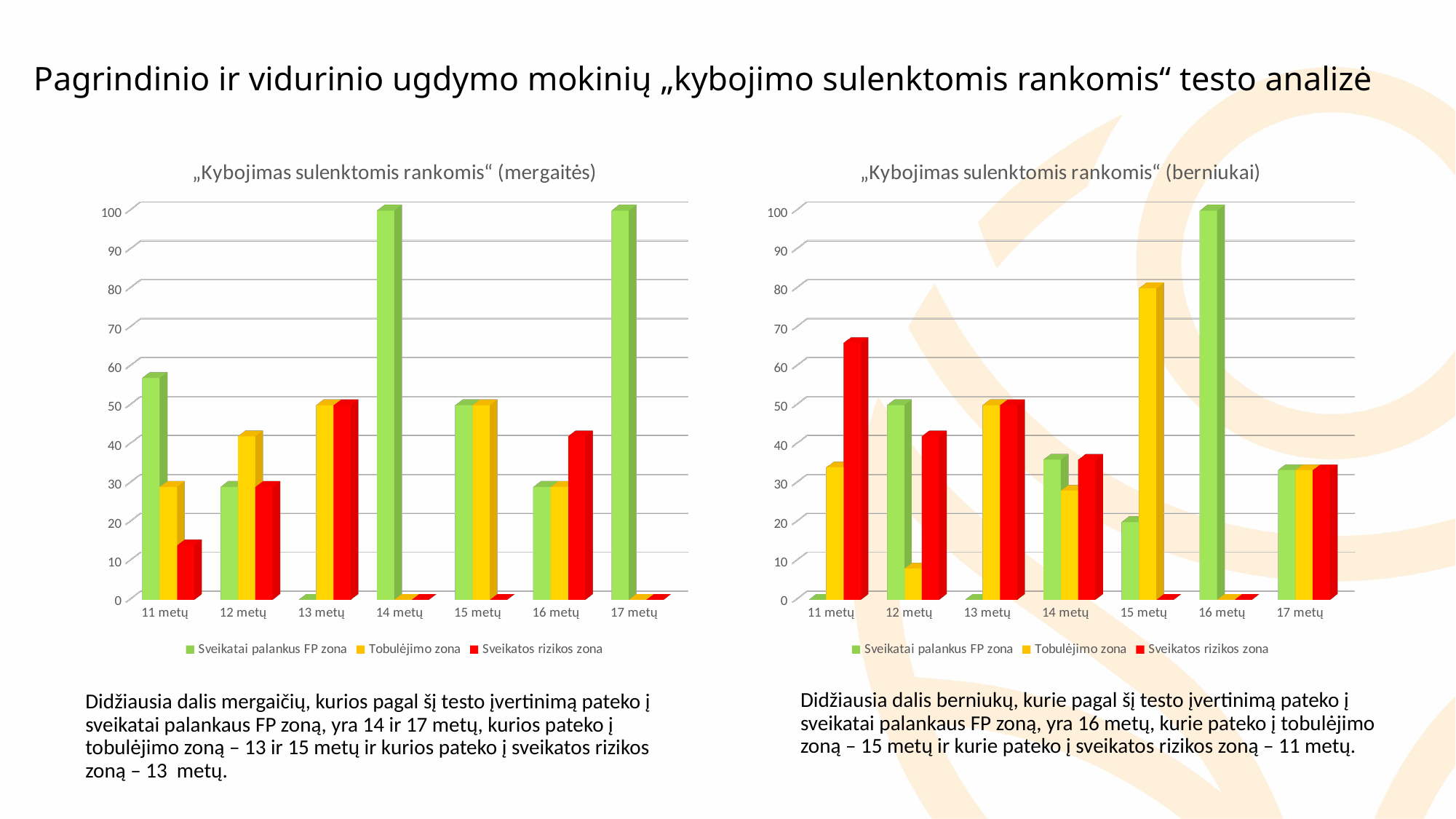
In the "Kybojimas sulenktomis rankomis" (berniukai) chart, which age group has the highest Sveikatos rizikos zona value? 11 metų In the "Kybojimas sulenktomis rankomis" (berniukai) chart, which is larger for 12 metų: Sveikatai palankus FP zona or Tobulėjimo zona? Sveikatai palankus FP zona Which colour represents Tobulėjimo zona in the legend of the "Kybojimas sulenktomis rankomis" (mergaitės) chart? yellow How many age categories are shown on the x axis of the "Kybojimas sulenktomis rankomis" (berniukai) chart? 7 In the "Kybojimas sulenktomis rankomis" (mergaitės) chart, which is larger for 16 metų: Sveikatai palankus FP zona or Sveikatos rizikos zona? Sveikatos rizikos zona In the "Kybojimas sulenktomis rankomis" (mergaitės) chart, is the Sveikatai palankus FP zona value for 11 metų greater or less than 50? greater How many series does the legend of the "Kybojimas sulenktomis rankomis" (mergaitės) chart list? 3 What kind of chart is the "Kybojimas sulenktomis rankomis" (mergaitės) chart? bar chart In the "Kybojimas sulenktomis rankomis" (mergaitės) chart, what is the value of Sveikatai palankus FP zona for 14 metų? 100 In the "Kybojimas sulenktomis rankomis" (berniukai) chart, what is the value of Sveikatai palankus FP zona for 16 metų? 100 In the "Kybojimas sulenktomis rankomis" (berniukai) chart, is the Sveikatos rizikos zona value for 11 metų greater or less than 60? greater In the "Kybojimas sulenktomis rankomis" (berniukai) chart, which age group has the highest Tobulėjimo zona value? 15 metų